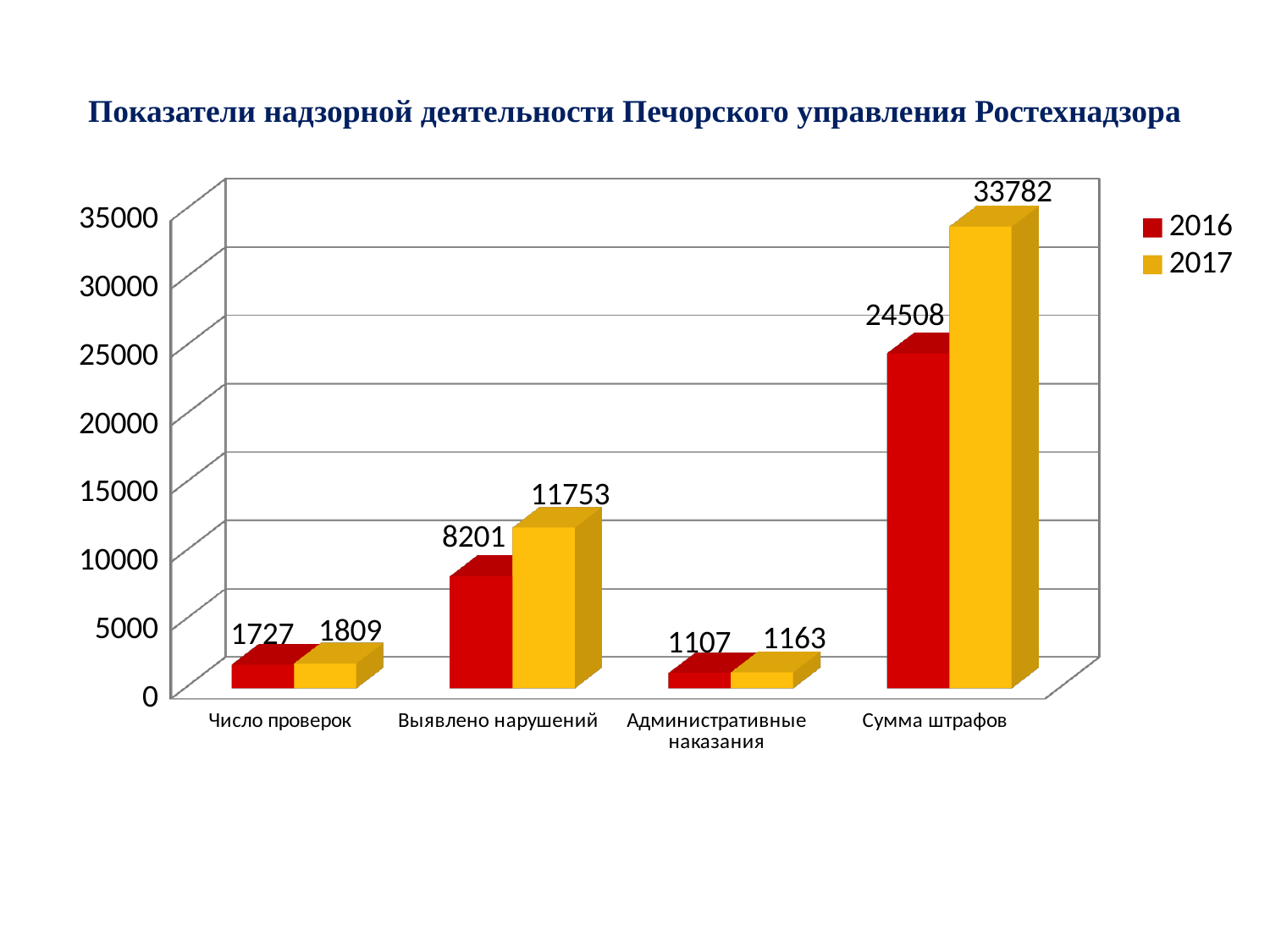
Which is larger for "Число проверок": the 2016 value or the 2017 value? 2017 What is the value for 2016 in the "Выявлено нарушений" category? 8201 What kind of chart is shown on the slide? Bar chart What is the value for 2016 in the "Административные наказания" category? 1107 How many series does the legend list? 2 How many categories are shown on the x axis? 4 Which category has the lowest value for 2016? Административные наказания Which category has the highest value for 2017? Сумма штрафов What is the difference between the 2017 and 2016 values for "Сумма штрафов"? 9274 What is the difference between the 2017 and 2016 values for "Выявлено нарушений"? 3552 What is the value for 2017 in the "Число проверок" category? 1809 What is the value for 2017 in the "Сумма штрафов" category? 33782